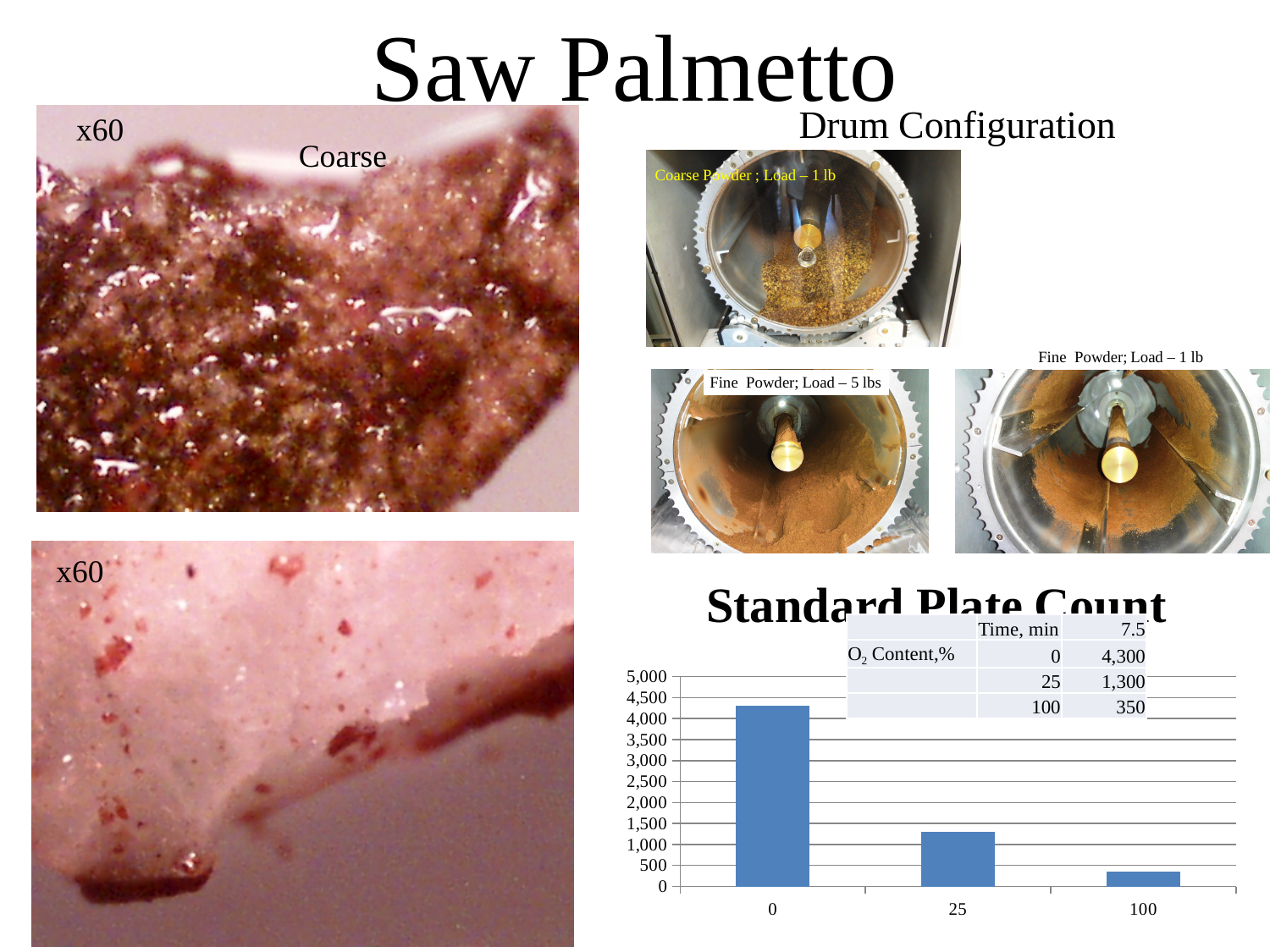
In the Standard Plate Count chart, what is the difference between the plate count at 0 min and at 25 min? 3,000 According to the table on the Standard Plate Count chart, what is the plate count at time 25 min? 1,300 In the Standard Plate Count chart, do the values rise or fall as time increases along the x axis? fall What kind of chart is the Standard Plate Count chart? bar chart In the Standard Plate Count chart, is the bar for 25 min greater or less than 1,000? greater In the Standard Plate Count chart, which time has the lowest plate count? 100 According to the table on the Standard Plate Count chart, what is the plate count at time 0 min? 4,300 In the Standard Plate Count chart, which time has the highest plate count? 0 In the Standard Plate Count chart, what is the difference between the plate count at 25 min and at 100 min? 950 What O2 content percentage is listed in the table on the Standard Plate Count chart? 7.5 According to the table on the Standard Plate Count chart, what is the plate count at time 100 min? 350 How many bars are plotted in the Standard Plate Count chart? 3